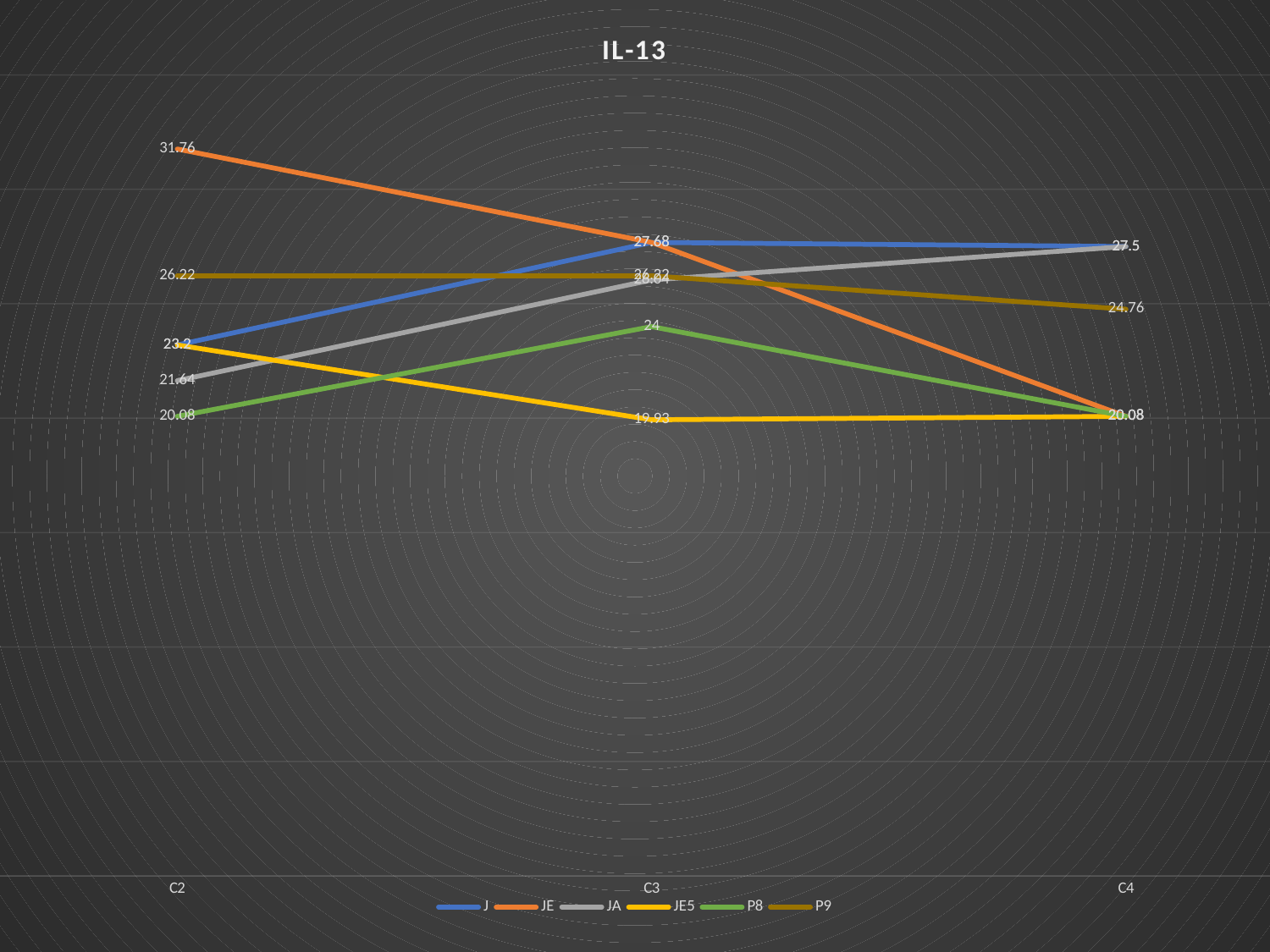
Which series has the lowest value at C3? JE5 How many categories are shown on the x axis? 3 What is the value of JE at C2? 31.76 What is the value of P9 at C4? 24.76 What is the title of the chart? IL-13 Which series has the highest value at C2? JE Does the JE series rise or fall from C2 to C4? fall What is the value of P8 at C3? 24 How many series does the legend list? 6 What is the difference between the P9 value at C2 and at C4? 1.46 What is the value of JE5 at C3? 19.93 What kind of chart is shown on the slide? line chart